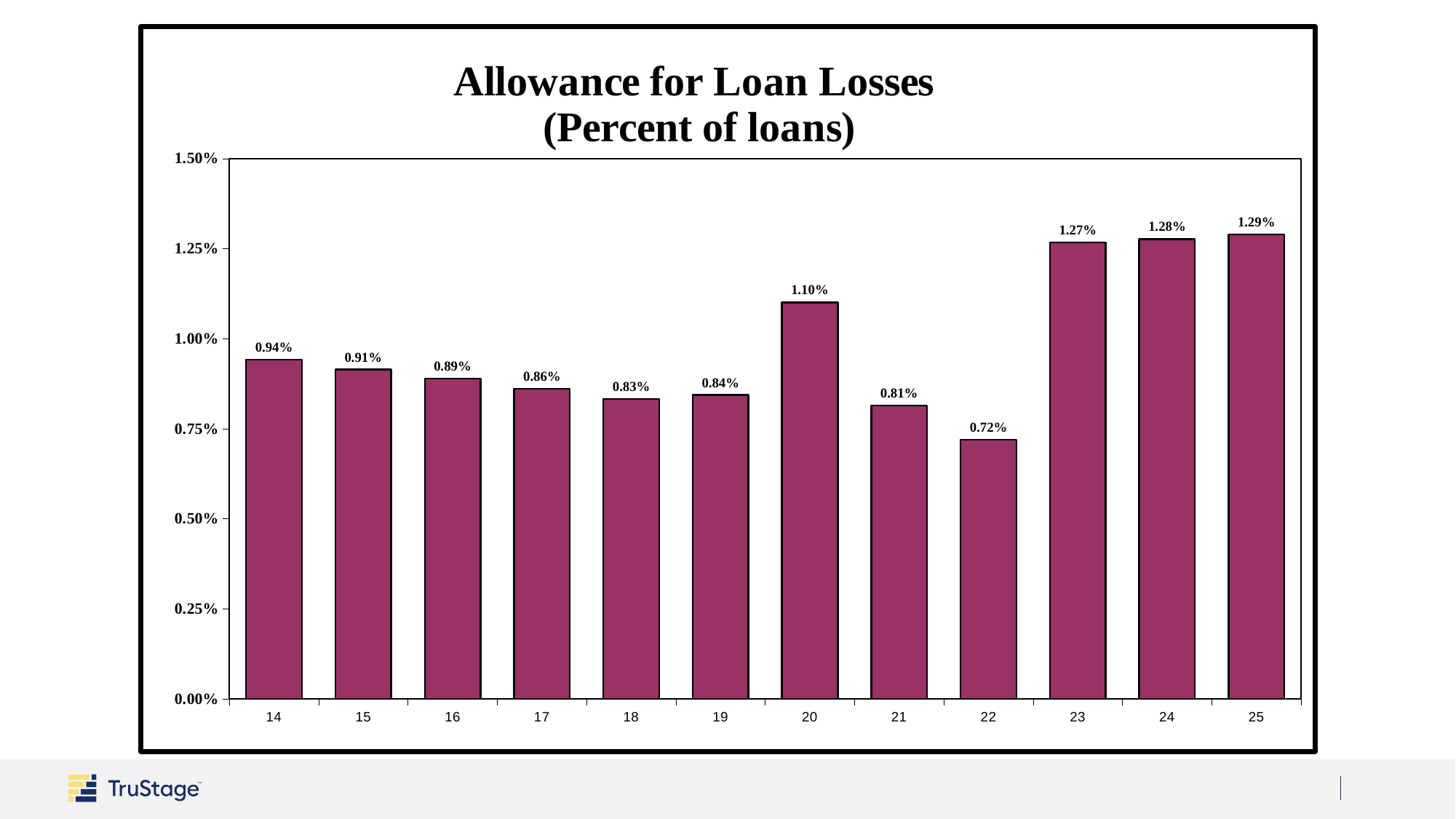
What is the allowance for loan losses for year 14? 0.94% How many years are shown on the chart? 12 Which year has a larger allowance for loan losses, year 20 or year 23? 23 What is the allowance for loan losses for year 20? 1.10% Which year has the highest allowance for loan losses? 25 What is the title of the chart? Allowance for Loan Losses (Percent of loans) Do the values rise or fall from year 14 to year 18? fall Is the value for year 21 greater or less than 1.00%? less What is the allowance for loan losses for year 22? 0.72% What is the difference between the allowance for loan losses in year 25 and year 22? 0.57% What kind of chart is shown on the slide? bar chart Which year has the lowest allowance for loan losses? 22